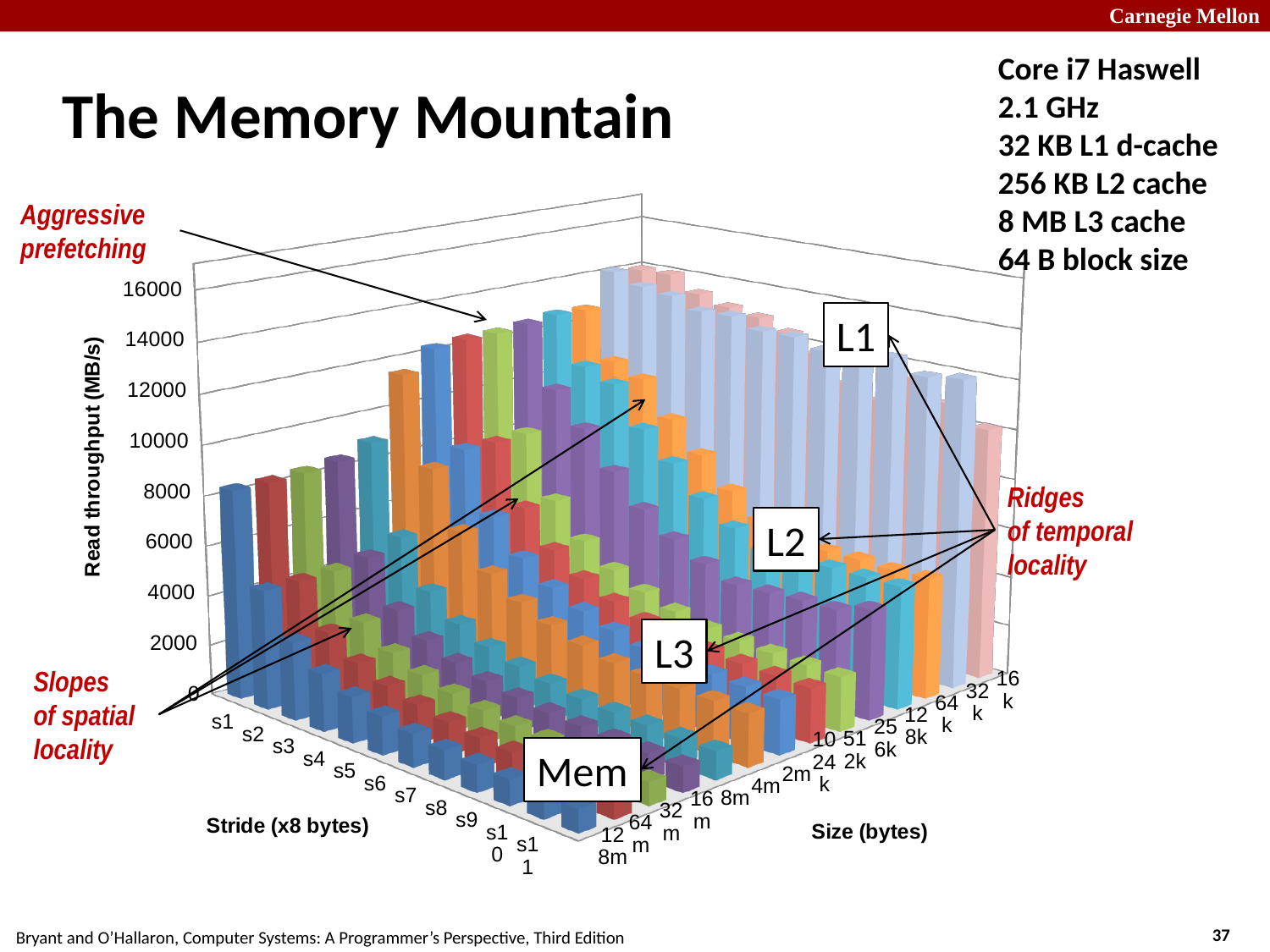
Which stride has the highest read throughput for size 128m? s1 Is the read throughput for stride s1 at size 128m greater or less than 12000 MB/s? less How many stride categories (s1 through s11) are shown along the stride axis? 11 For stride s1, does read throughput rise or fall as the working-set size decreases from 128m toward 32k? rise What is the title of the chart on the slide? The Memory Mountain For a fixed size of 128m, does read throughput rise or fall as the stride increases from s1 to s11? fall What is the label of the vertical axis of the chart? Read throughput (MB/s) Is the read throughput for stride s11 at size 128m greater or less than 4000 MB/s? less How many size categories are shown along the Size (bytes) axis? 14 What kind of chart is shown on the slide? 3D bar chart Which is larger: the read throughput at stride s1 for size 32k, or at stride s1 for size 128m? stride s1 for size 32k